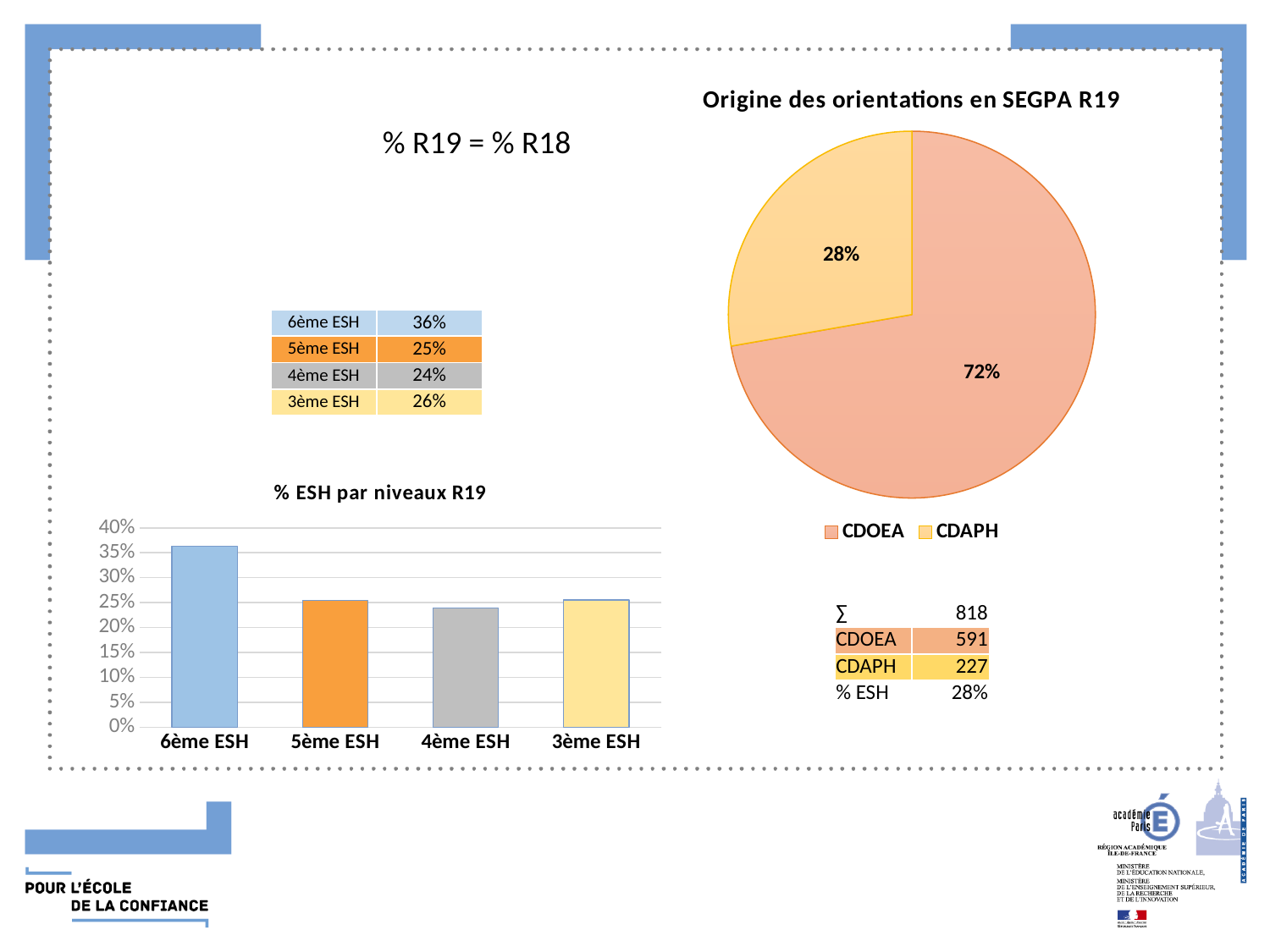
In the "% ESH par niveaux R19" chart, how many categories are shown on the x axis? 4 In the "% ESH par niveaux R19" chart, which is larger, the value for 6ème ESH or the value for 3ème ESH? 6ème ESH How many entries does the legend of the "Origine des orientations en SEGPA R19" pie chart list? 2 What kind of chart is "% ESH par niveaux R19"? bar chart In the "Origine des orientations en SEGPA R19" pie chart, what is the difference between the CDOEA share and the CDAPH share? 44% According to the table above the "% ESH par niveaux R19" chart, what is the value for 5ème ESH? 25% In the "% ESH par niveaux R19" chart, is the value for 4ème ESH greater or less than 25%? less In the "Origine des orientations en SEGPA R19" pie chart, what share does CDOEA have? 72% In the "% ESH par niveaux R19" chart, is the value for 6ème ESH greater or less than 30%? greater In the "% ESH par niveaux R19" chart, which category has the highest value? 6ème ESH What kind of chart is "Origine des orientations en SEGPA R19"? pie chart In the "Origine des orientations en SEGPA R19" pie chart, what share does CDAPH have? 28%